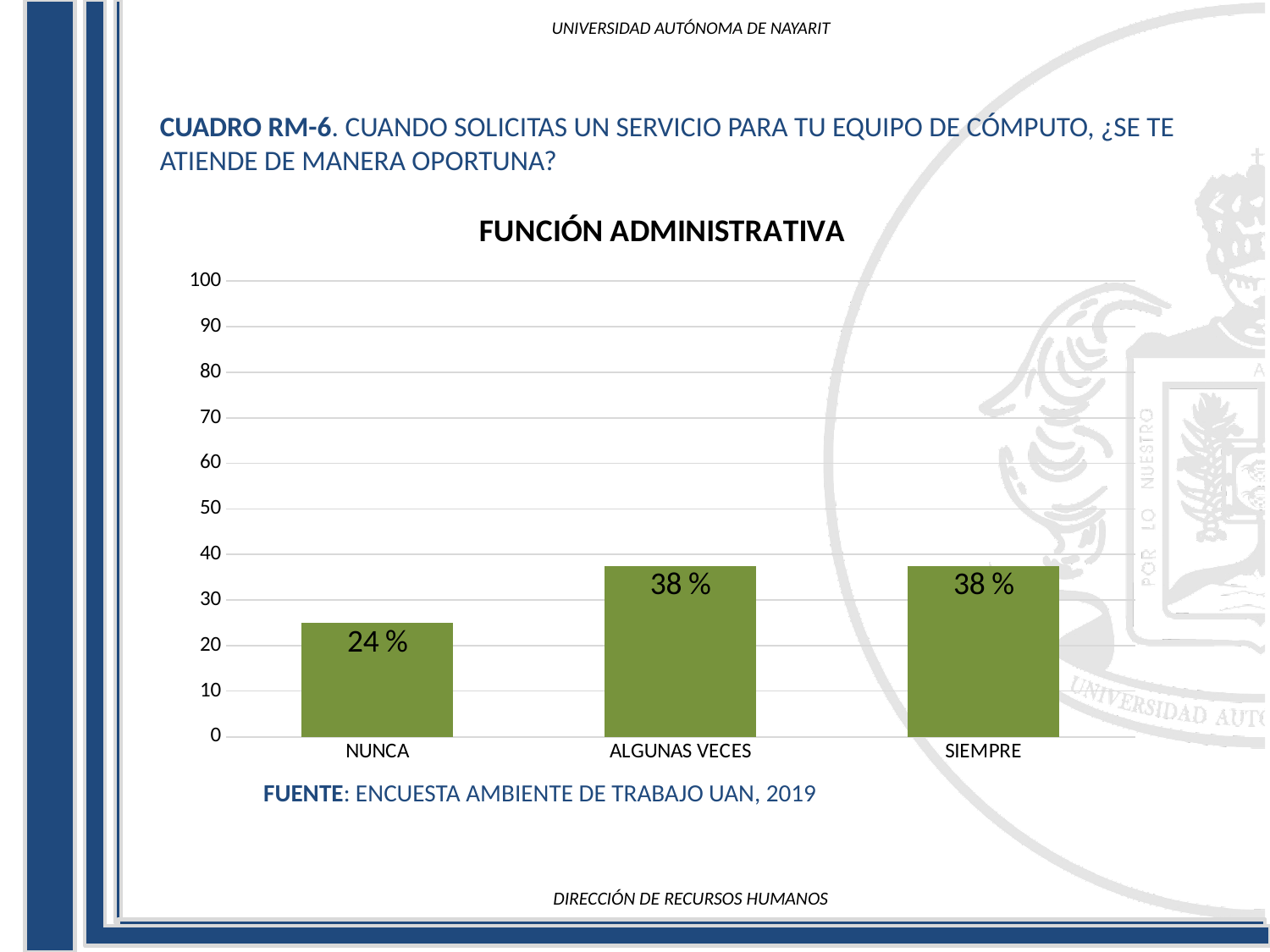
What is the difference between the values for ALGUNAS VECES and NUNCA? 14 % How many categories are shown on the x axis? 3 What kind of chart is shown on the slide? bar chart Is the value for SIEMPRE greater or less than 30? greater What is the value for ALGUNAS VECES? 38 % What is the value for NUNCA? 24 % What is the title of the chart? FUNCIÓN ADMINISTRATIVA What is the value for SIEMPRE? 38 % Is the value for NUNCA greater or less than 30? less Which category has the lowest value? NUNCA What is the maximum value shown on the y axis? 100 Which is larger, the value for NUNCA or the value for SIEMPRE? SIEMPRE